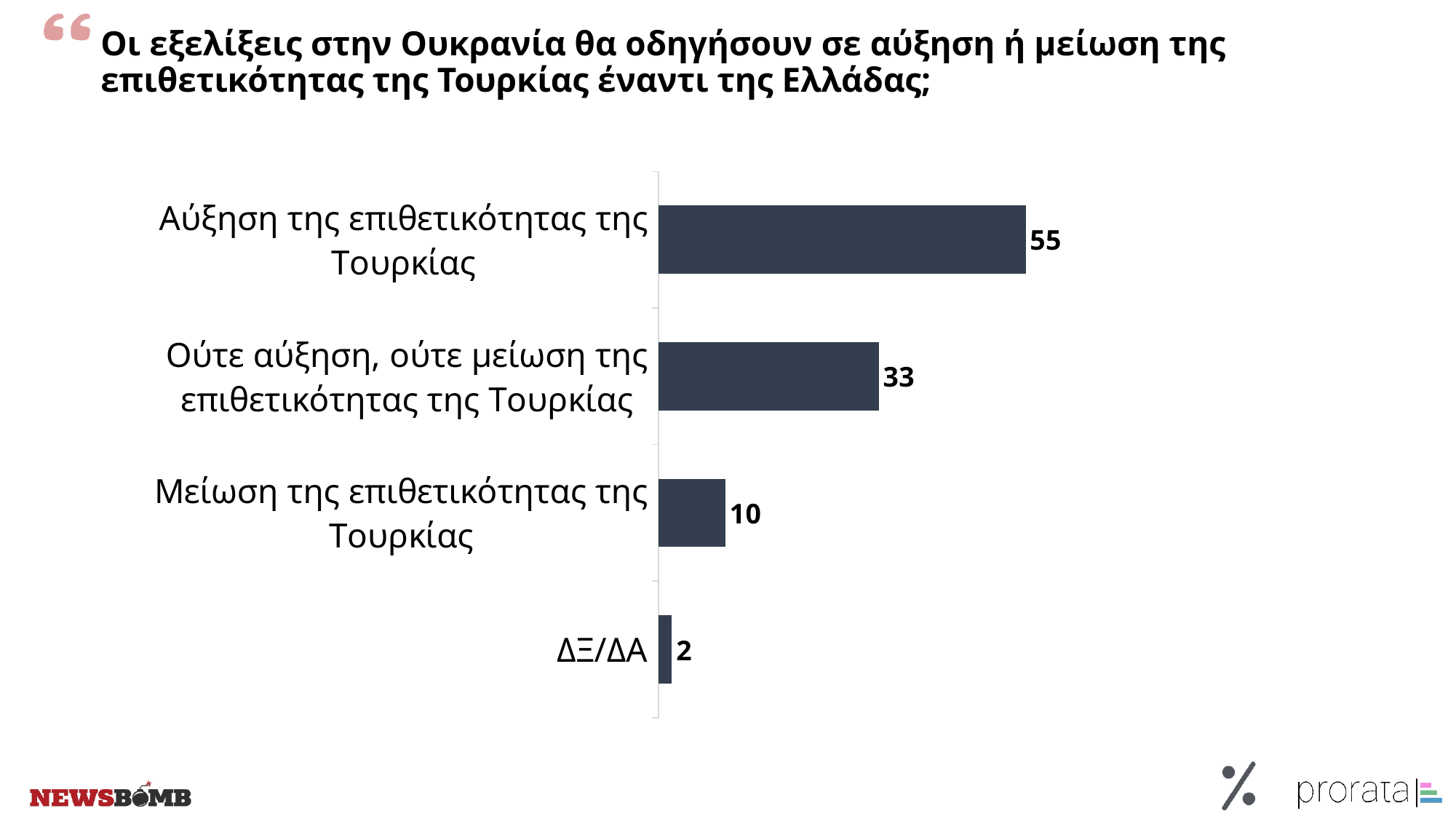
What is the value for "Ούτε αύξηση, ούτε μείωση της επιθετικότητας της Τουρκίας"? 33 What is the value for "ΔΞ/ΔΑ"? 2 Which category has the lowest value? ΔΞ/ΔΑ What is the difference between the values for "Μείωση της επιθετικότητας της Τουρκίας" and "ΔΞ/ΔΑ"? 8 Which category has the highest value? Αύξηση της επιθετικότητας της Τουρκίας What is the difference between the values for "Αύξηση της επιθετικότητας της Τουρκίας" and "Ούτε αύξηση, ούτε μείωση της επιθετικότητας της Τουρκίας"? 22 What is the title of the chart? Οι εξελίξεις στην Ουκρανία θα οδηγήσουν σε αύξηση ή μείωση της επιθετικότητας της Τουρκίας έναντι της Ελλάδας; What is the value for "Αύξηση της επιθετικότητας της Τουρκίας"? 55 What kind of chart is shown on the slide? Bar chart Which is larger: the value for "Ούτε αύξηση, ούτε μείωση της επιθετικότητας της Τουρκίας" or the value for "Μείωση της επιθετικότητας της Τουρκίας"? Ούτε αύξηση, ούτε μείωση της επιθετικότητας της Τουρκίας What is the value for "Μείωση της επιθετικότητας της Τουρκίας"? 10 How many categories are shown in the chart? 4